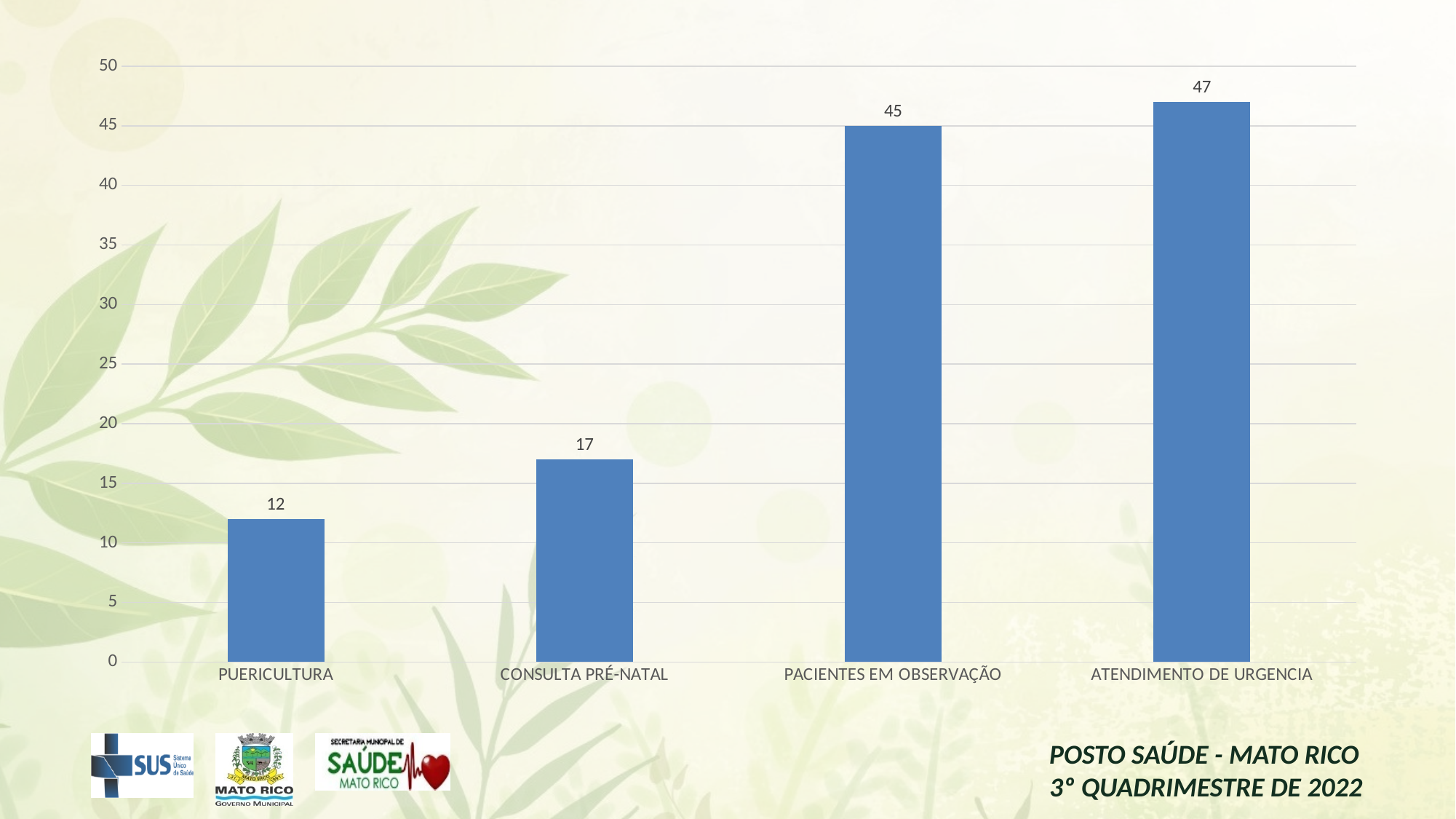
What is the value for PACIENTES EM OBSERVAÇÃO? 45 What is the difference between the values for CONSULTA PRÉ-NATAL and PUERICULTURA? 5 How many categories are shown on the chart? 4 What kind of chart is shown on the slide? bar chart What is the value for CONSULTA PRÉ-NATAL? 17 What is the value for PUERICULTURA? 12 What is the difference between the values for ATENDIMENTO DE URGENCIA and PACIENTES EM OBSERVAÇÃO? 2 Which category has the lowest value? PUERICULTURA Is the value for PACIENTES EM OBSERVAÇÃO greater or less than 40? greater Which is larger, the value for PACIENTES EM OBSERVAÇÃO or the value for CONSULTA PRÉ-NATAL? PACIENTES EM OBSERVAÇÃO Which category has the highest value? ATENDIMENTO DE URGENCIA What is the value for ATENDIMENTO DE URGENCIA? 47